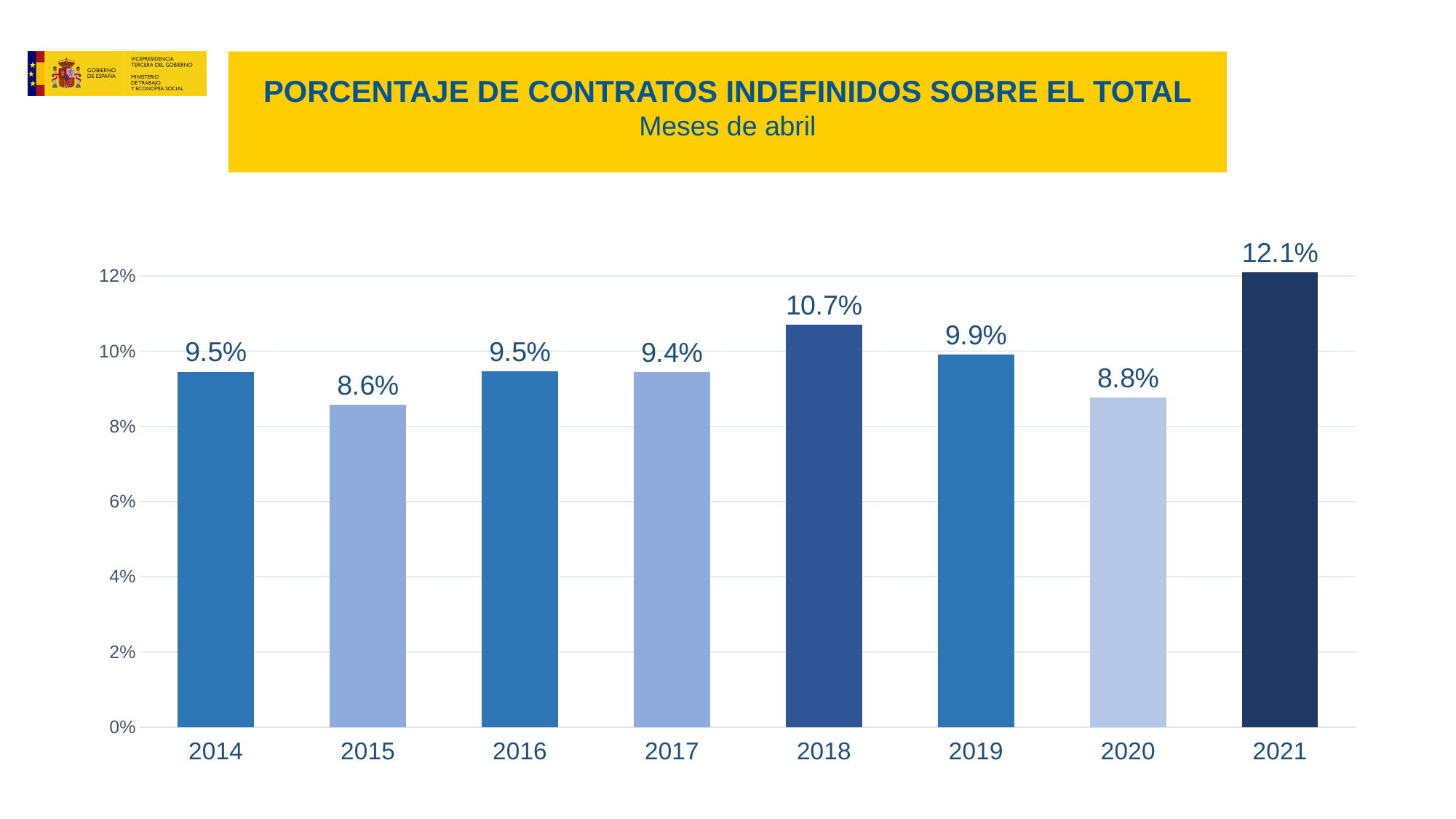
Which year has the lowest value? 2015 What is the difference between the values for 2018 and 2019? 0.8% Which is larger, the value for 2019 or the value for 2017? 2019 How many years are shown on the x axis? 8 What is the value for 2018? 10.7% What is the value for 2015? 8.6% What is the title of the chart? PORCENTAJE DE CONTRATOS INDEFINIDOS SOBRE EL TOTAL What is the value for 2020? 8.8% What is the difference between the values for 2021 and 2020? 3.3% Which year has the highest value? 2021 What kind of chart is shown on the slide? bar chart Is the value for 2021 greater or less than 12%? greater